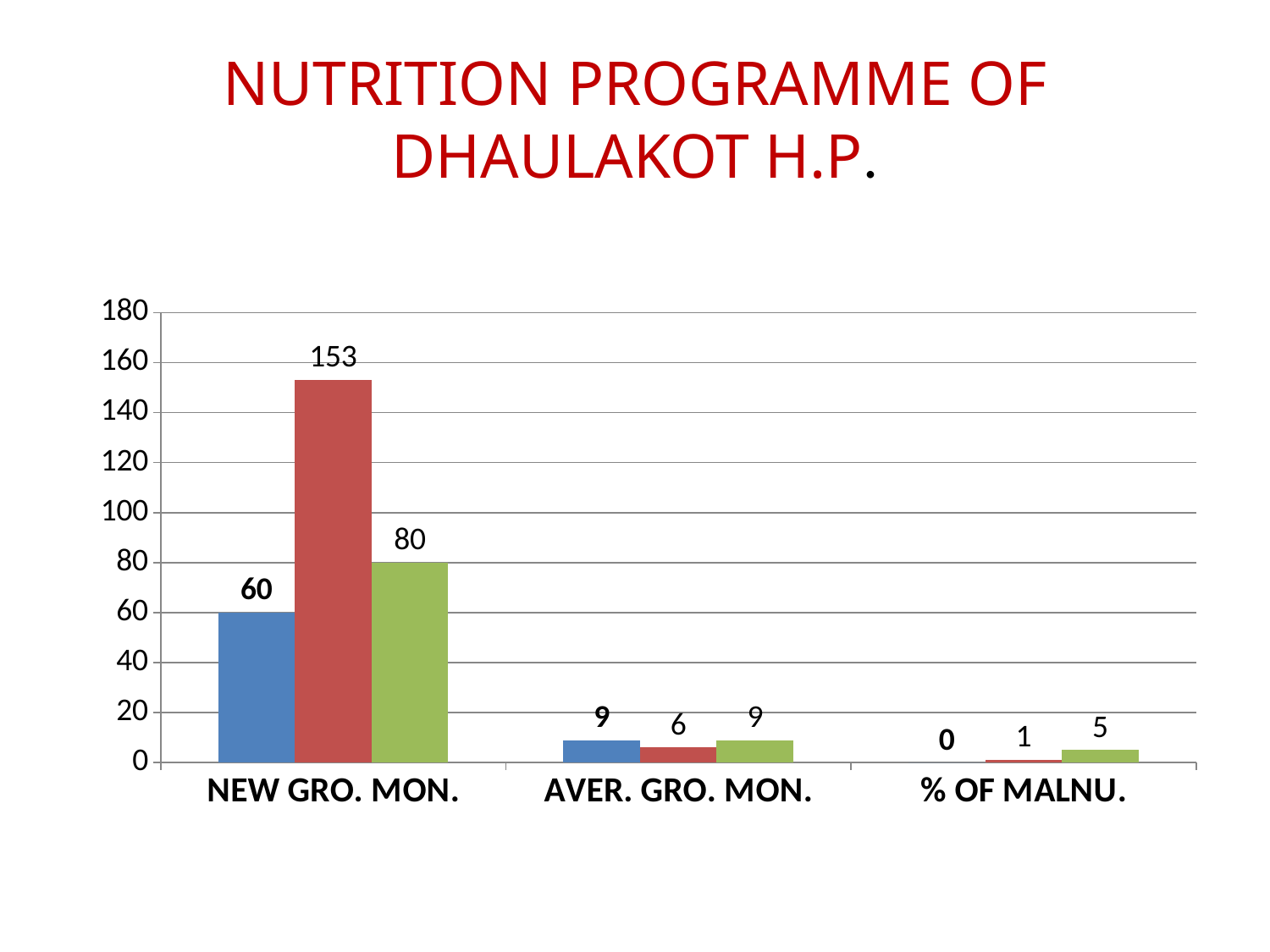
What is the value of the red bar for AVER. GRO. MON.? 6 Is the value of the red bar for NEW GRO. MON. greater or less than 140? greater Which category has the highest bar in the chart? NEW GRO. MON. What is the title of the slide containing the chart? NUTRITION PROGRAMME OF DHAULAKOT H.P. How many categories are shown on the x axis of the chart? 3 For NEW GRO. MON., which is larger, the blue bar or the green bar? green bar What is the value of the red bar for NEW GRO. MON.? 153 What is the difference between the green bar and the blue bar for NEW GRO. MON.? 20 What is the value of the green bar for % OF MALNU.? 5 What type of chart is shown on the slide? bar chart What is the difference between the red bar and the green bar for NEW GRO. MON.? 73 What is the value of the blue bar for NEW GRO. MON.? 60